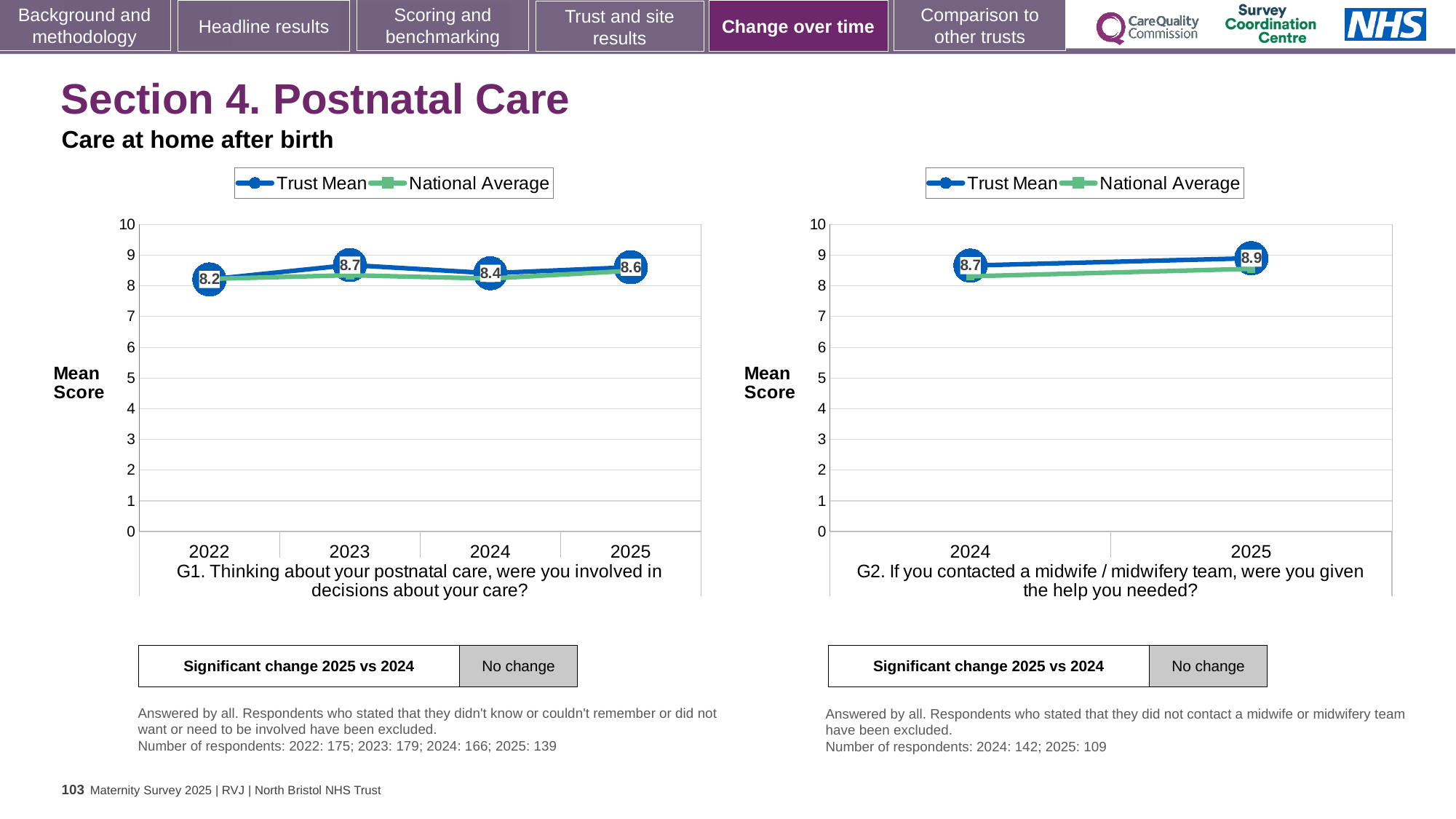
In the G2 chart on the right, is the National Average for 2024 greater or less than 9? less In the G2 chart on the right, what is the difference between the Trust Mean for 2025 and 2024? 0.2 In the G1 chart on the left, which year has the highest Trust Mean? 2023 What kind of chart is the G2 chart on the right? line chart In the G1 chart on the left, how many years are plotted on the x axis? 4 In the G1 chart on the left, what is the Trust Mean for 2023? 8.7 In the G2 chart on the right, what is the Trust Mean for 2025? 8.9 In the G1 chart on the left, what is the Trust Mean for 2022? 8.2 How many series does the legend of the G1 chart on the left list? 2 In the G2 chart on the right, does the Trust Mean rise or fall from 2024 to 2025? rise In the G1 chart on the left, which year has the lowest Trust Mean? 2022 In the G1 chart on the left, what is the difference between the Trust Mean for 2023 and 2022? 0.5